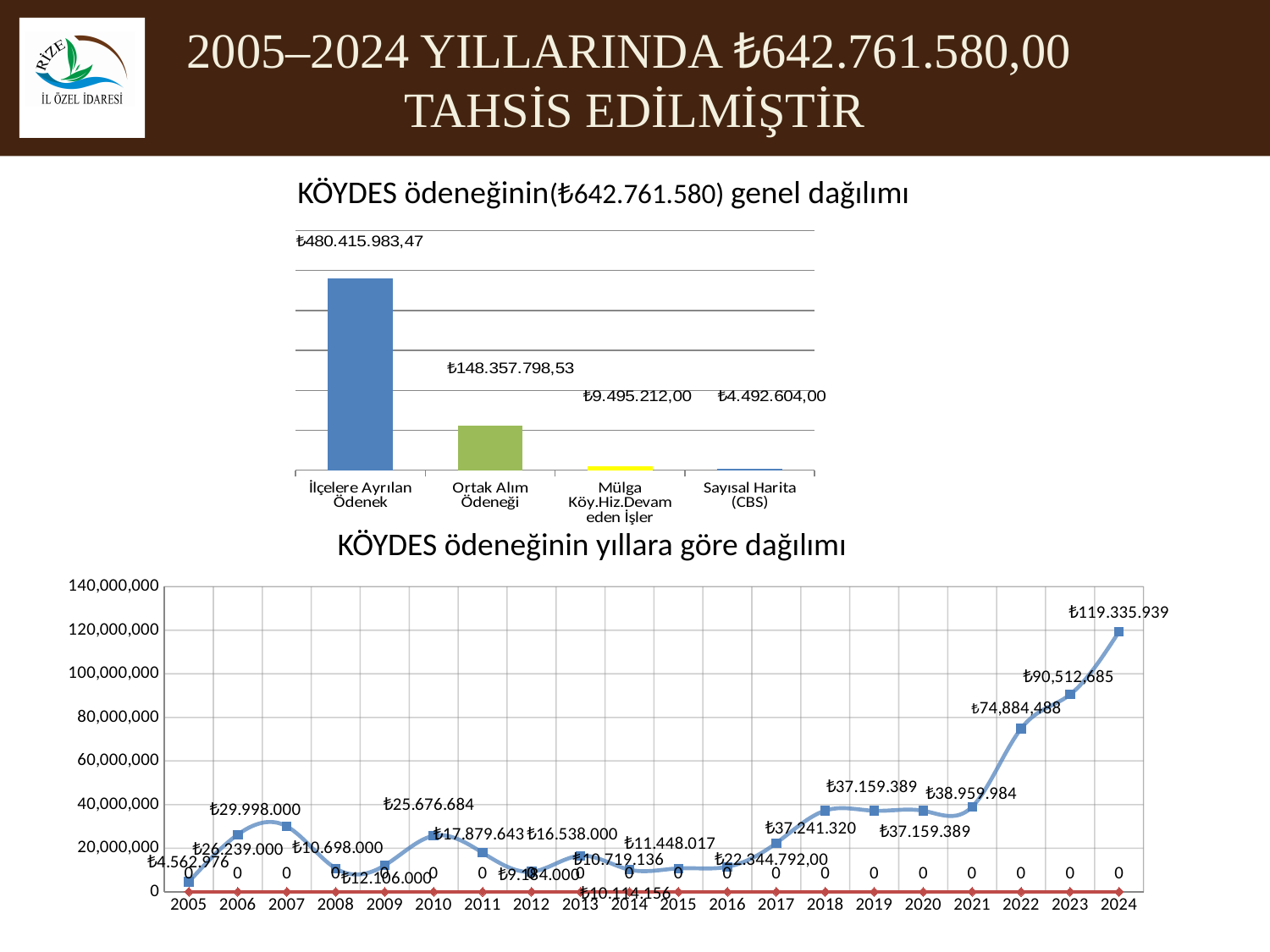
In the top chart 'KÖYDES ödeneğinin genel dağılımı', what is the value for İlçelere Ayrılan Ödenek? ₺480.415.983,47 In the top chart 'KÖYDES ödeneğinin genel dağılımı', which category has the lowest value? Sayısal Harita (CBS) In the bottom chart 'KÖYDES ödeneğinin yıllara göre dağılımı', what is the value for 2023? ₺90,512,685 In the top chart 'KÖYDES ödeneğinin genel dağılımı', which category has the highest value? İlçelere Ayrılan Ödenek In the bottom chart 'KÖYDES ödeneğinin yıllara göre dağılımı', which year has the highest value? 2024 In the bottom chart 'KÖYDES ödeneğinin yıllara göre dağılımı', what is the value for 2024? ₺119.335.939 In the bottom chart 'KÖYDES ödeneğinin yıllara göre dağılımı', how many years are shown on the x axis? 20 What kind of chart is the top chart 'KÖYDES ödeneğinin genel dağılımı'? Bar chart In the top chart 'KÖYDES ödeneğinin genel dağılımı', what is the value for Ortak Alım Ödeneği? ₺148.357.798,53 In the top chart 'KÖYDES ödeneğinin genel dağılımı', how many categories are shown? 4 In the bottom chart 'KÖYDES ödeneğinin yıllara göre dağılımı', is the value for 2022 greater or less than 60,000,000? greater In the top chart 'KÖYDES ödeneğinin genel dağılımı', what is the value for Sayısal Harita (CBS)? ₺4.492.604,00